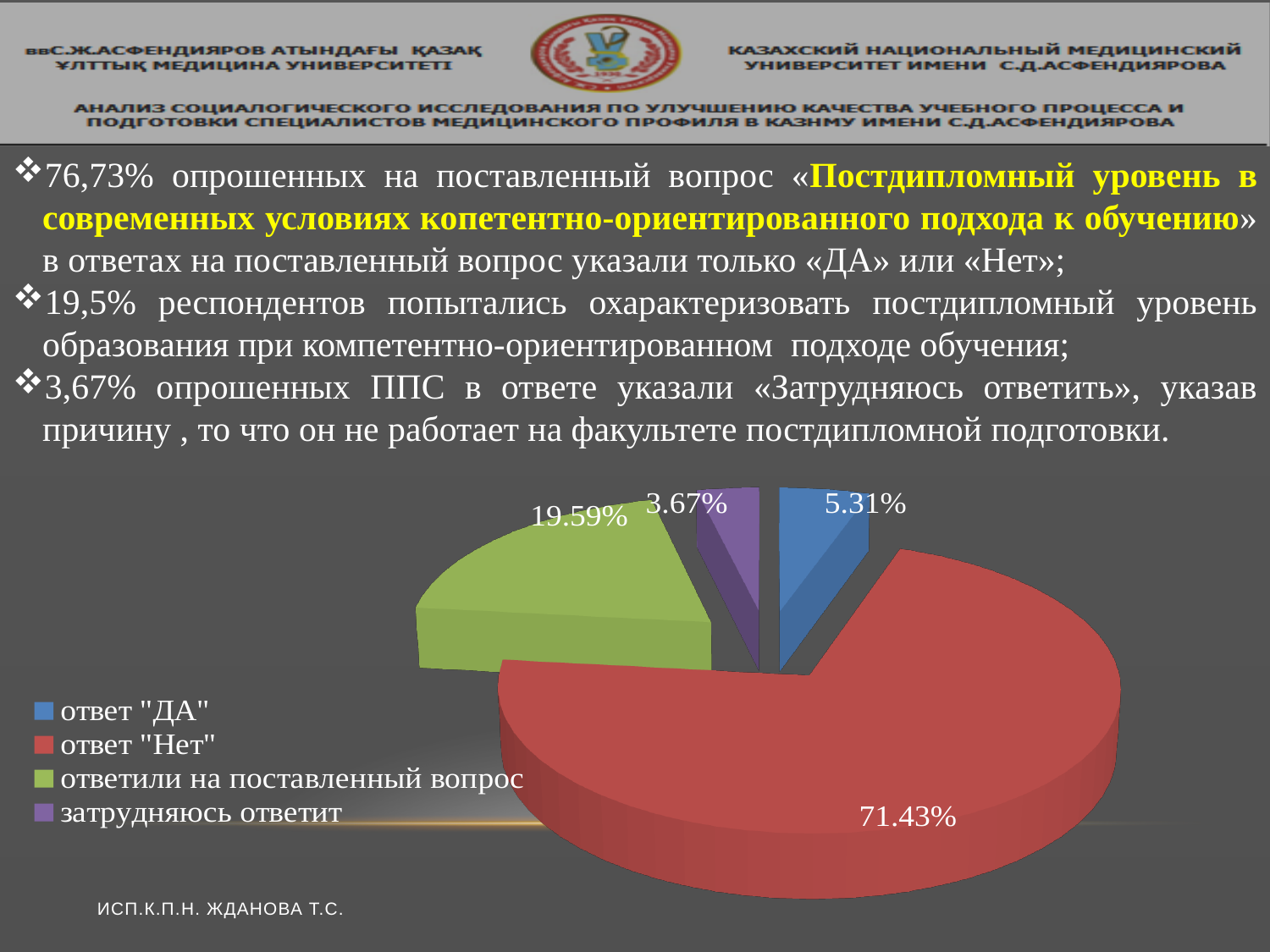
What percentage does the slice for ответили на поставленный вопрос show? 19.59% What is the difference between the ответ "Нет" slice and the ответили на поставленный вопрос slice? 51.84% What percentage does the slice for затрудняюсь ответит show? 3.67% What colour is the slice for ответили на поставленный вопрос? green What percentage does the slice for ответ "Нет" show? 71.43% How many slices does the pie chart have? 4 Which category has the largest slice of the pie? ответ "Нет" What percentage does the slice for ответ "ДА" show? 5.31% Which category has the smallest slice of the pie? затрудняюсь ответит What kind of chart is shown on the slide? pie chart Which is larger, the slice for ответ "ДА" or the slice for затрудняюсь ответит? ответ "ДА" How many entries does the legend list? 4